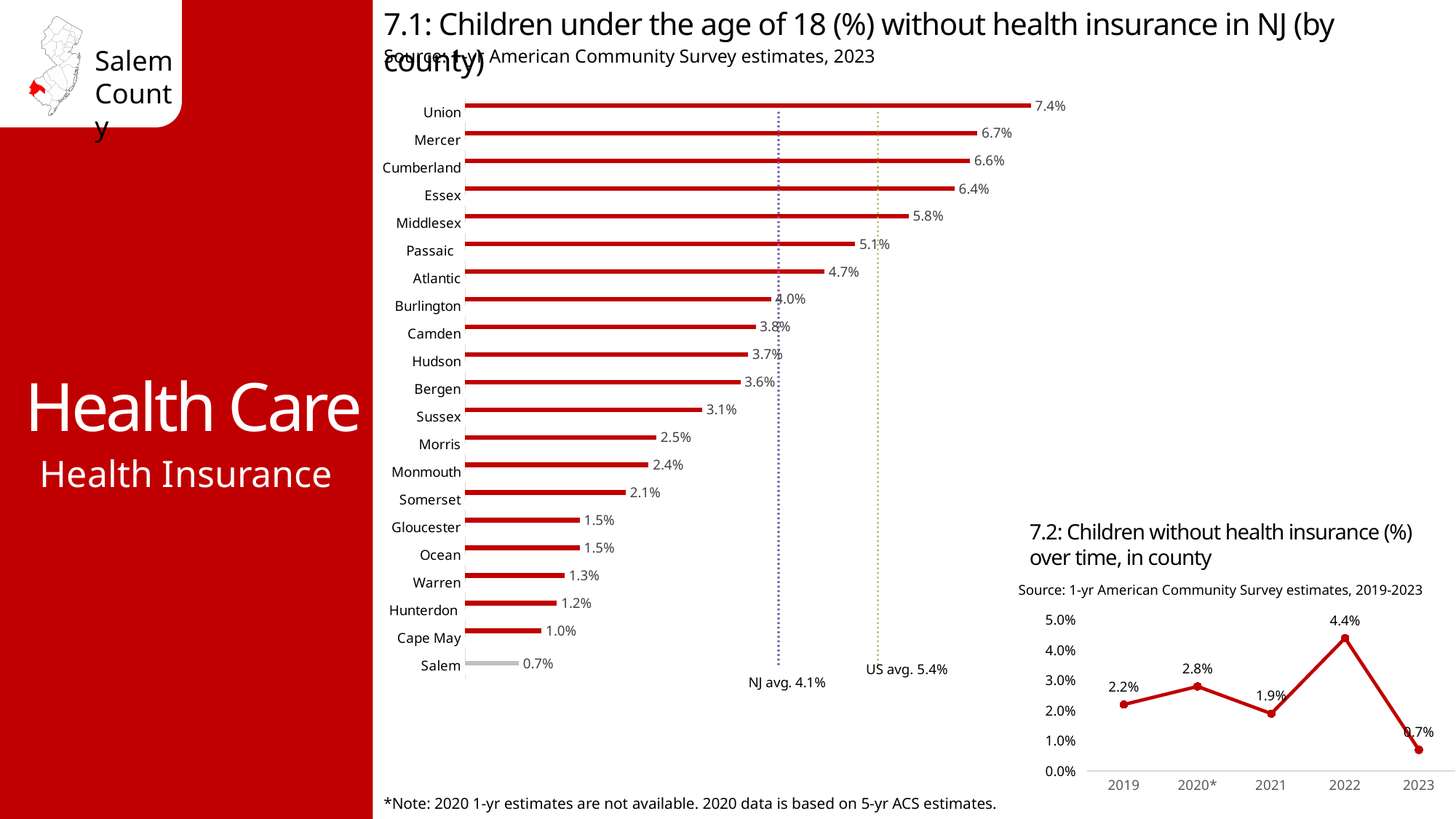
In chart 7.2, which year has the lowest value? 2023 In chart 7.1, which county has the highest percentage of children without health insurance? Union In chart 7.1, what is the NJ average shown by the dotted reference line? 4.1% In chart 7.1 (children under 18 without health insurance by county), what is the value for Cumberland? 6.6% In chart 7.1, what is the difference between the values for Union and Salem? 6.7 percentage points In chart 7.2, what is the difference between the 2022 and 2023 values? 3.7 percentage points In chart 7.1, which county has a higher value, Passaic or Atlantic? Passaic What type of chart is chart 7.2? Line chart In chart 7.2 (children without health insurance over time in county), what is the value for 2022? 4.4% What type of chart is chart 7.1? Bar chart In chart 7.1, how many counties are shown? 21 In chart 7.1, which county has the lowest percentage of children without health insurance? Salem